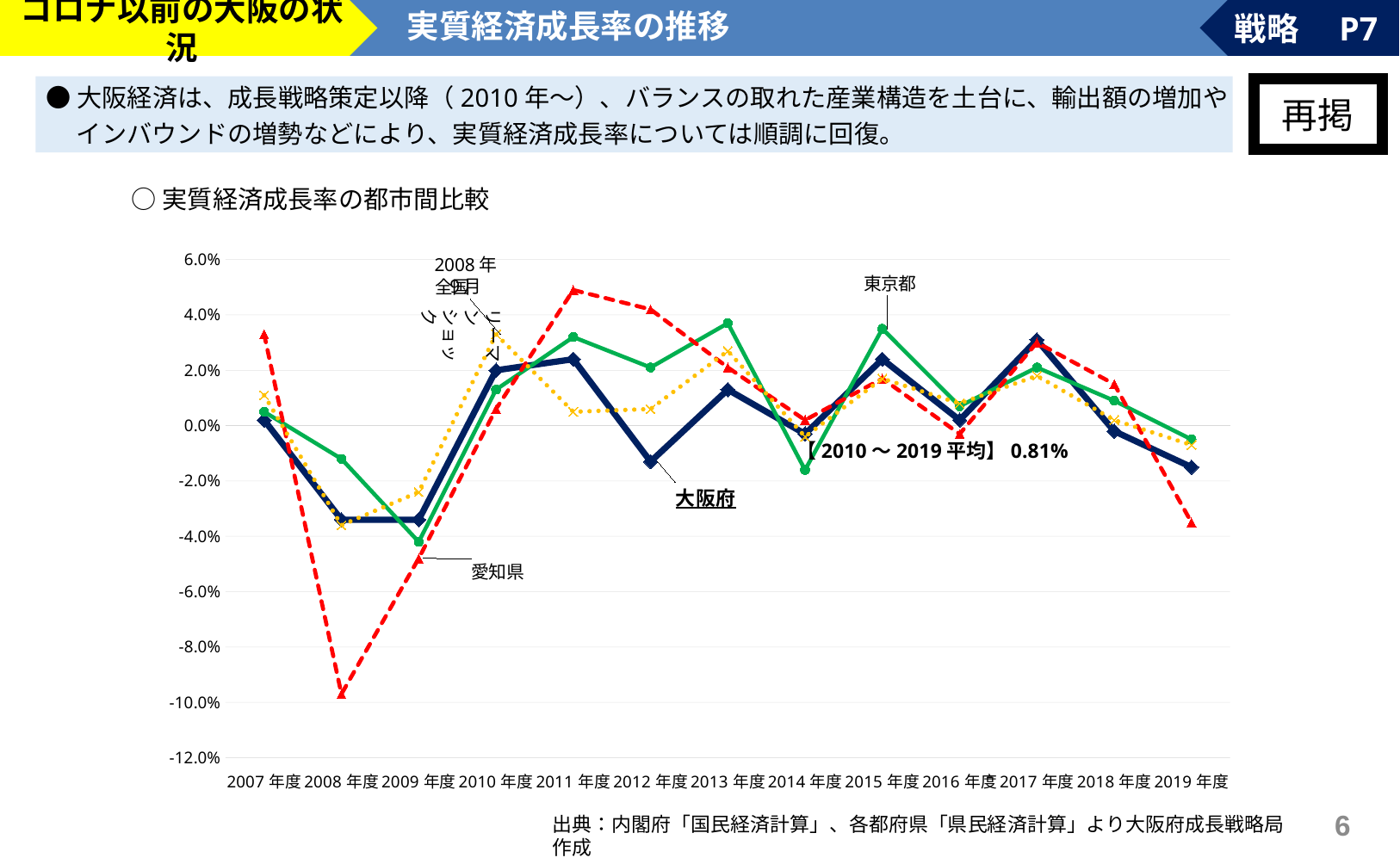
What kind of chart is shown on the slide? line chart Is the value for 東京都 in 2014年度 greater or less than 0.0%? less Is the value for 愛知県 in 2011年度 greater or less than 4.0%? greater Is the value for 愛知県 in 2008年度 greater or less than -8.0%? less What is the title printed above the chart? 実質経済成長率の都市間比較 What value is printed on the chart for the 2010～2019 average? 0.81% How many fiscal years are plotted along the x axis of the chart? 13 In which fiscal year does 愛知県 reach its lowest value in the chart? 2008年度 In 2015年度, which is larger: the value for 東京都 or the value for 大阪府? 東京都 Does the value for 大阪府 rise or fall from 2017年度 to 2019年度? fall Which series is drawn as a red dashed line in the chart? 愛知県